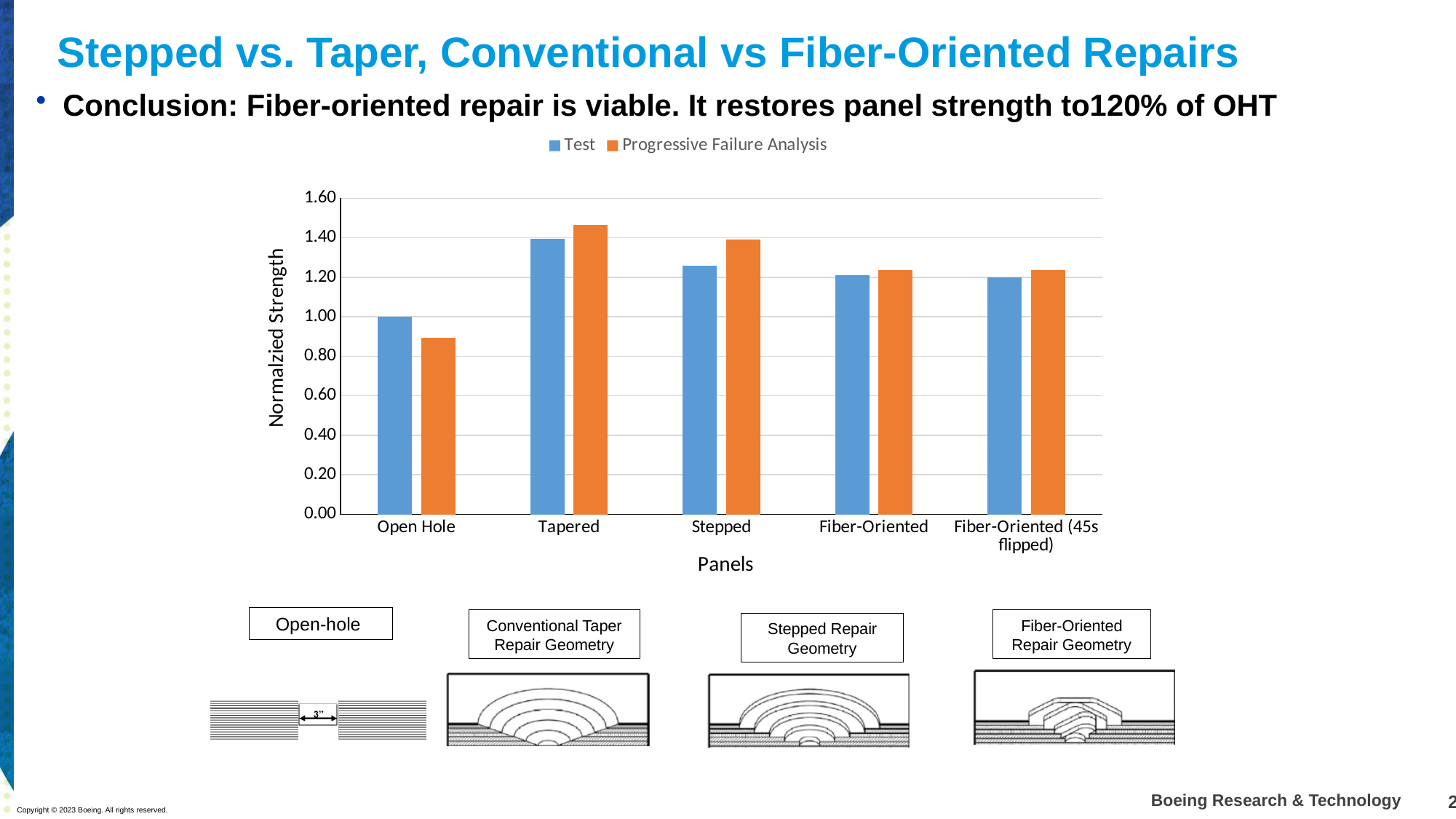
What is the Test value for Open Hole in the chart? 1.00 How many series does the chart legend list? 2 What kind of chart is shown on the slide? Bar chart Which panel has the highest Test value in the chart? Tapered Is the Progressive Failure Analysis value for Open Hole greater or less than 1.00? less How many panel categories are shown on the x axis of the chart? 5 What is the title of the x axis of the chart? Panels Is the Test value for Stepped greater or less than 1.20? greater Which panel has the lowest Progressive Failure Analysis value in the chart? Open Hole For Open Hole, which is larger: the Test value or the Progressive Failure Analysis value? Test Is the Progressive Failure Analysis value for Tapered greater or less than 1.40? greater Which is larger: the Test value for Tapered or the Test value for Stepped? Tapered